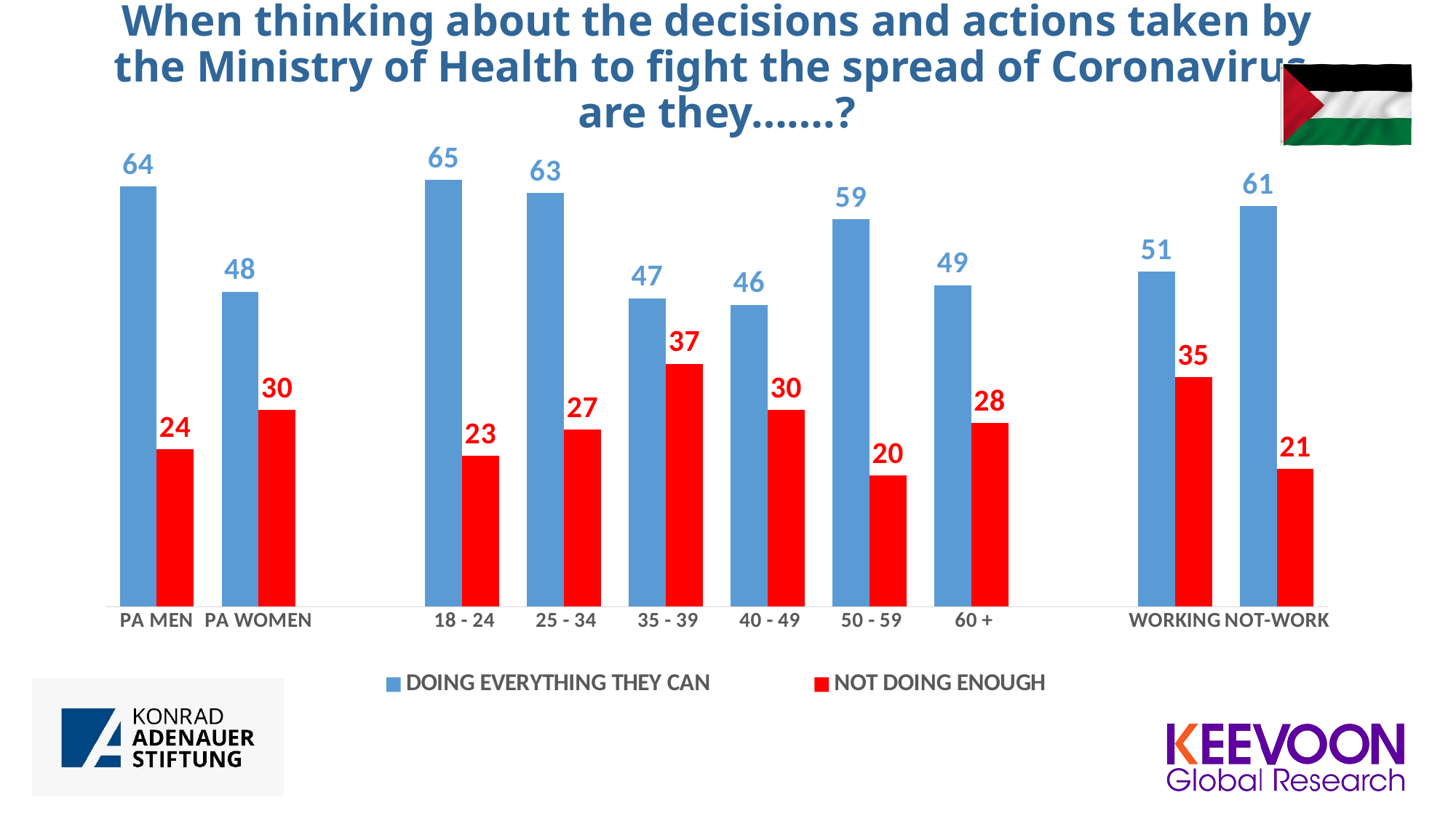
What is the value for 'DOING EVERYTHING THEY CAN' among PA MEN? 64 Which category has the highest value for 'DOING EVERYTHING THEY CAN'? 18 - 24 Which is larger: the 'NOT DOING ENOUGH' value for WORKING or for NOT-WORK? WORKING What is the difference between the 'NOT DOING ENOUGH' values for the 35 - 39 and 50 - 59 age groups? 17 How many series does the legend list? 2 What kind of chart is shown on the slide? Bar chart What colour represents 'NOT DOING ENOUGH' in the legend? Red Which category has the lowest value for 'NOT DOING ENOUGH'? 50 - 59 What is the value for 'NOT DOING ENOUGH' in the 35 - 39 age group? 37 How many categories are shown on the x axis? 10 What is the difference between the 'DOING EVERYTHING THEY CAN' values for PA MEN and PA WOMEN? 16 What is the value for 'DOING EVERYTHING THEY CAN' among those NOT-WORK? 61